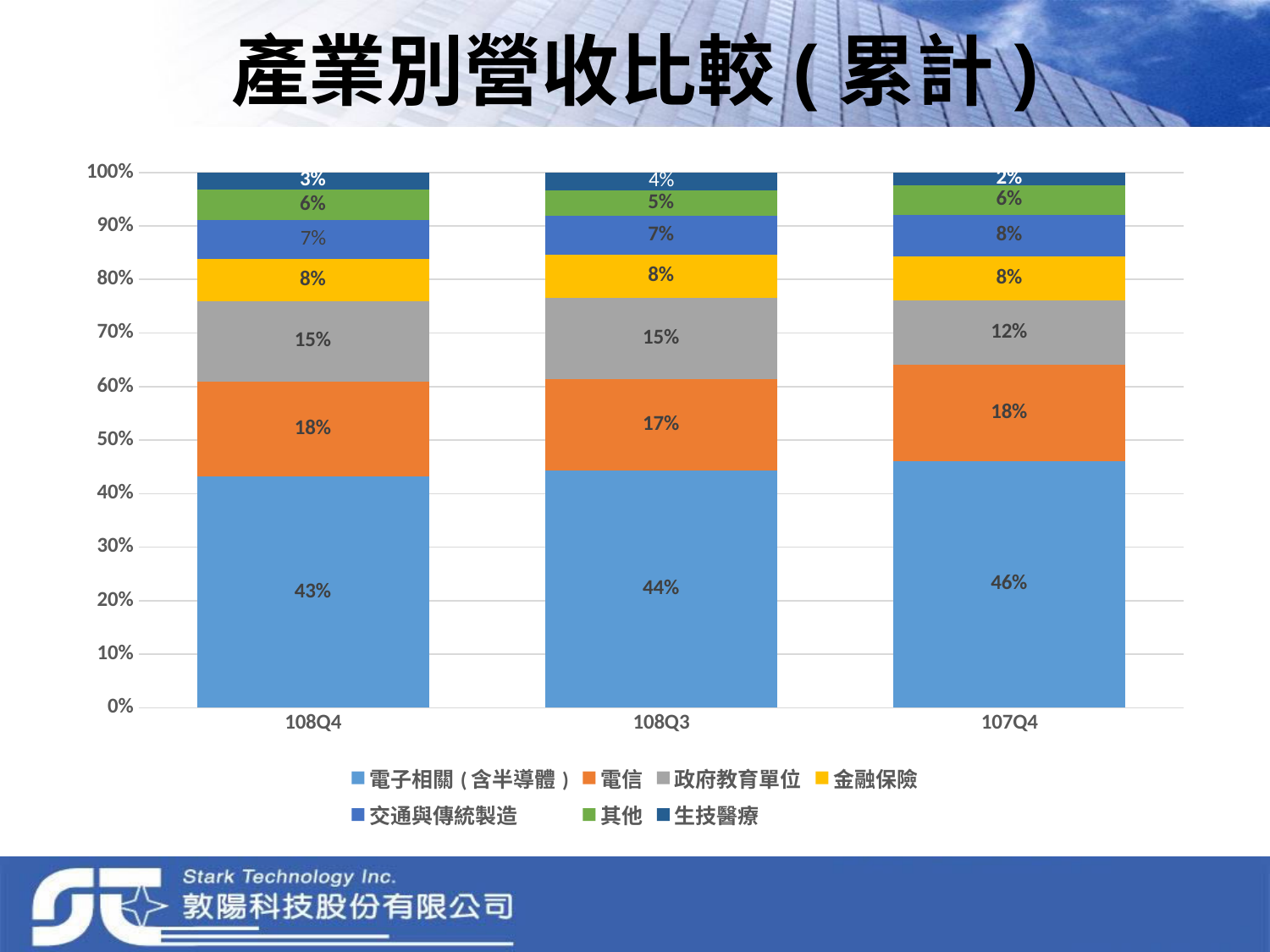
What is the value for 生技醫療 in 108Q3? 4% What is the difference between the 政府教育單位 share in 108Q4 and in 107Q4? 3% What is the value for 政府教育單位 in 107Q4? 12% What kind of chart is shown on the slide? Stacked bar chart What is the title of the chart? 產業別營收比較（累計） Which is larger: the 其他 share in 108Q4 or in 108Q3? 108Q4 In which period is the 生技醫療 share the lowest? 107Q4 How many categories (periods) are shown on the x axis? 3 What is the value for 電子相關（含半導體） in 108Q4? 43% How many series does the legend list? 7 What is the value for 電信 in 108Q3? 17% In which period is the 電子相關（含半導體） share the highest? 107Q4